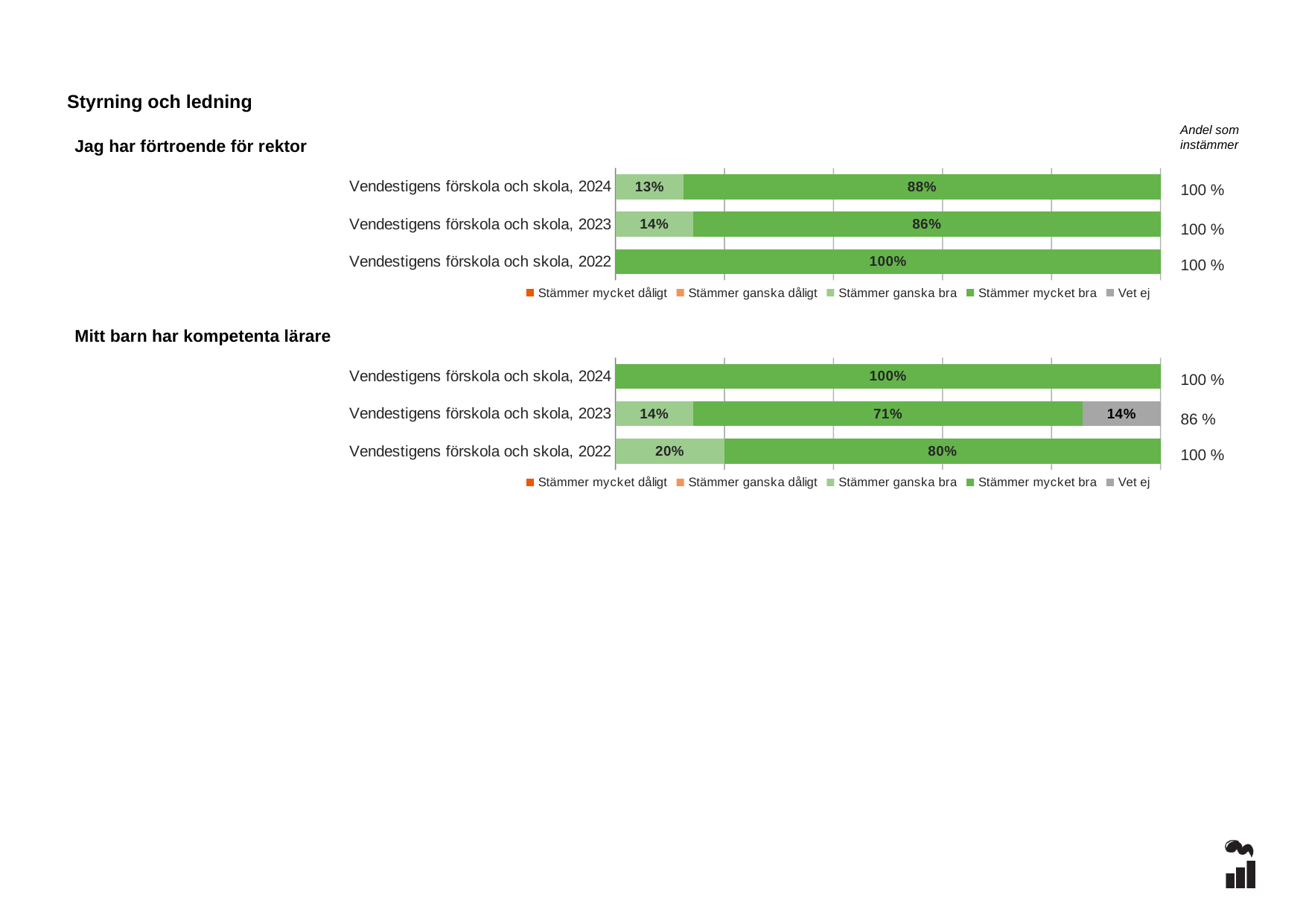
In the chart 'Mitt barn har kompetenta lärare', is the 'Stämmer mycket bra' value for 2022 larger or smaller than for 2023? larger In the chart 'Jag har förtroende för rektor', what is the difference between the 'Stämmer mycket bra' values for 2024 and 2023? 2% How many series does the legend of the chart 'Mitt barn har kompetenta lärare' list? 5 In the chart 'Jag har förtroende för rektor', which year has the highest 'Stämmer mycket bra' value? 2022 What kind of chart is 'Jag har förtroende för rektor'? Stacked bar chart In the chart 'Mitt barn har kompetenta lärare', which year has the lowest 'Stämmer mycket bra' value? 2023 In the chart 'Mitt barn har kompetenta lärare', what is the 'Andel som instämmer' shown for Vendestigens förskola och skola, 2023? 86 % In the chart 'Mitt barn har kompetenta lärare', what is the value for 'Stämmer ganska bra' for Vendestigens förskola och skola, 2022? 20% How many bars does the chart 'Jag har förtroende för rektor' contain? 3 In the chart 'Jag har förtroende för rektor', what is the value for 'Stämmer ganska bra' for Vendestigens förskola och skola, 2023? 14% In the chart 'Mitt barn har kompetenta lärare', what is the value for 'Vet ej' for Vendestigens förskola och skola, 2023? 14% In the chart 'Jag har förtroende för rektor', what is the value for 'Stämmer mycket bra' for Vendestigens förskola och skola, 2024? 88%